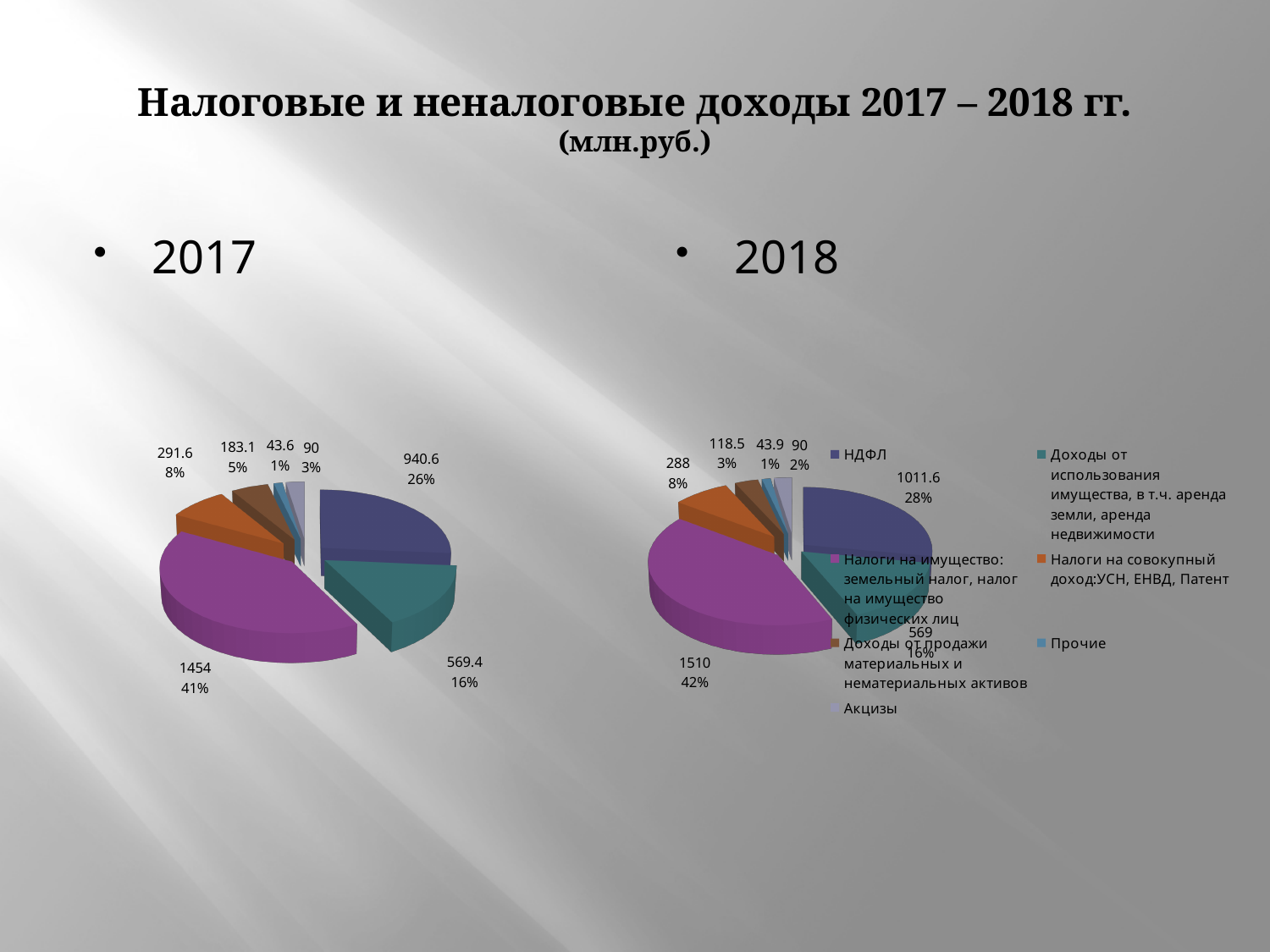
How many entries does the legend list? 7 In the 2018 pie chart, what is the value of the smallest slice? 43.9 In the 2017 pie chart, what is the value of the НДФЛ slice? 940.6 In the 2018 pie chart, what share does the НДФЛ slice have? 28% What type of charts are shown on the slide? Pie charts In the 2018 pie chart, what is the value of the largest slice? 1510 What is the difference between the НДФЛ value in the 2018 chart (1011.6) and in the 2017 chart (940.6)? 71 How many slices does each pie chart have? 7 Which is larger: the 291.6 slice in the 2017 chart or the 288 slice in the 2018 chart? 291.6 in the 2017 chart In the 2017 pie chart, what share does the largest slice (1454) have? 41% In the 2017 pie chart, what is the value of the smallest slice? 43.6 In the 2017 pie chart, what is the value of the largest slice? 1454